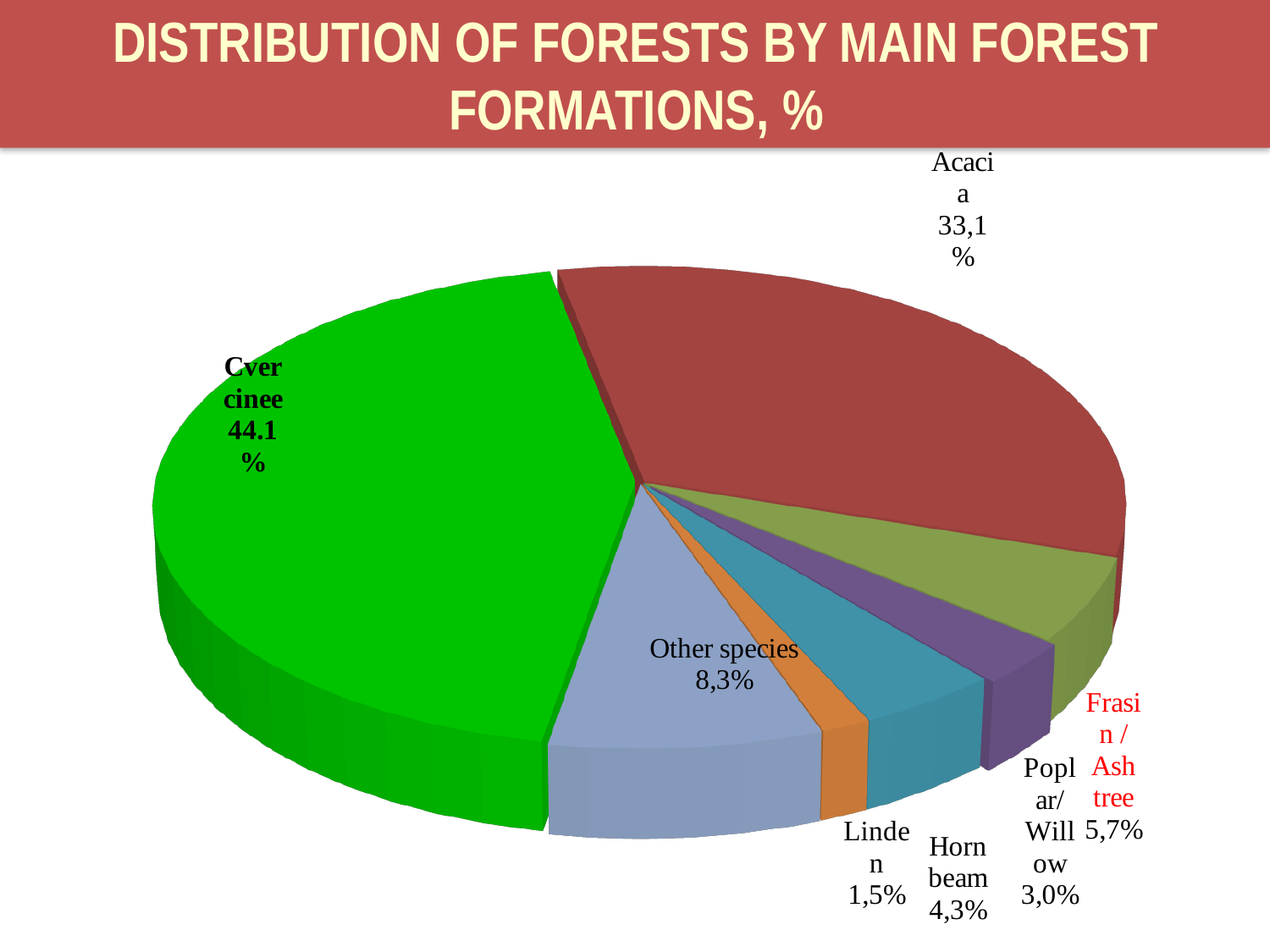
What kind of chart is shown on the slide? Pie chart What share of forests is Frasin / Ash tree? 5,7% Which has a larger share, Hornbeam or Poplar/Willow? Hornbeam Which forest formation has the smallest share? Linden What share of forests is Acacia? 33,1% What share of forests is Linden? 1,5% What share of forests is Poplar/Willow? 3,0% Which forest formation has the largest share? Cvercinee How many slices does the pie chart have? 7 What share of forests is Hornbeam? 4,3% What share of forests is Other species? 8,3% What share of forests is Cvercinee? 44.1%